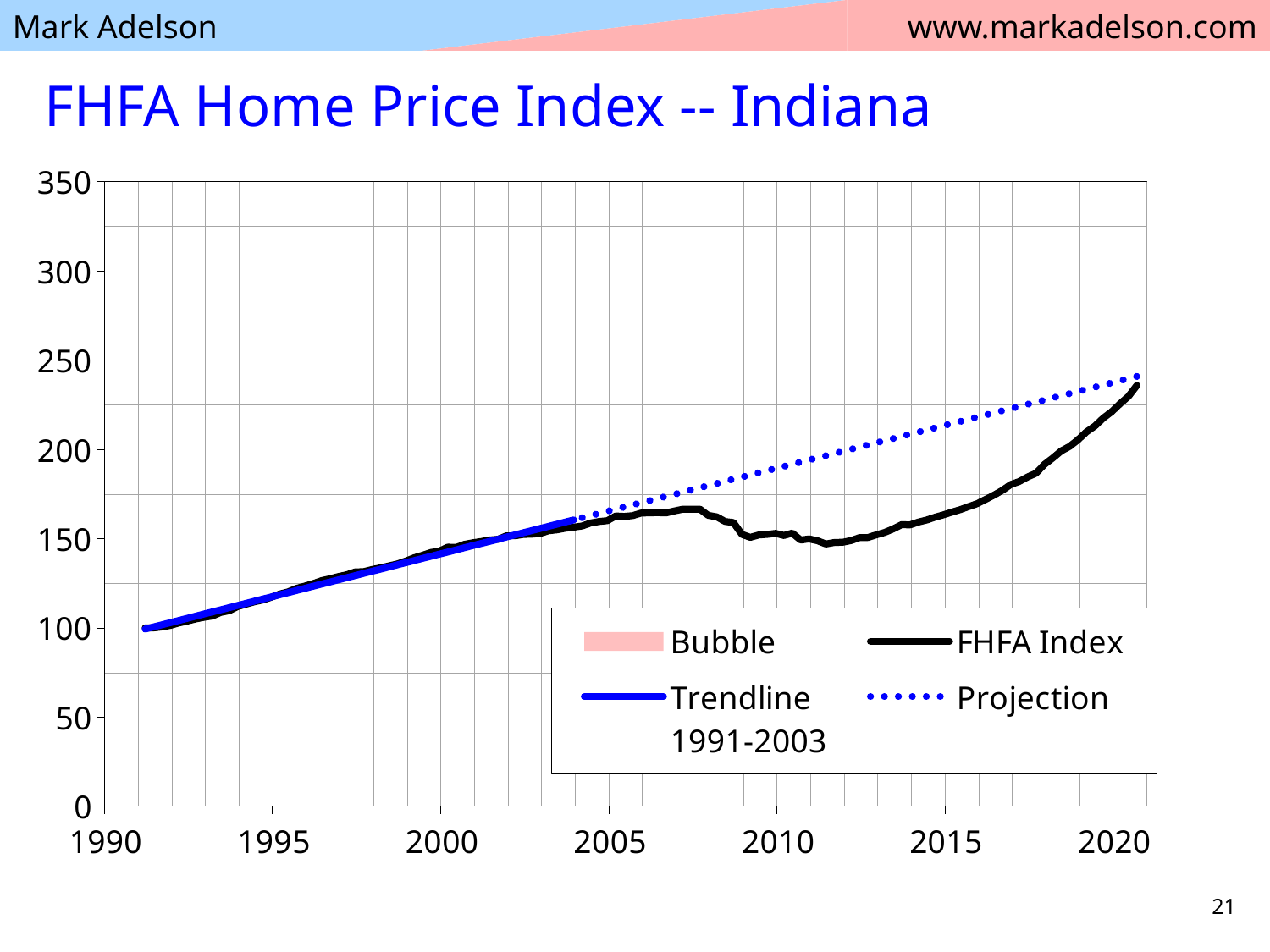
What kind of chart is shown on the slide? line chart Is the value of the FHFA Index in 2015 greater or less than 150? greater Is the value of the FHFA Index in 2010 greater or less than 200? less Which is higher for the FHFA Index: the value in 2010 or the value in 2020? 2020 Which legend entry is drawn as a blue dotted line? Projection Is the value of the FHFA Index in 1995 greater or less than 150? less What is the title of the chart? FHFA Home Price Index -- Indiana How many series does the legend list? 4 Does the FHFA Index rise or fall between 2012 and 2020? rise In 2015, which is higher: the Projection line or the FHFA Index? Projection